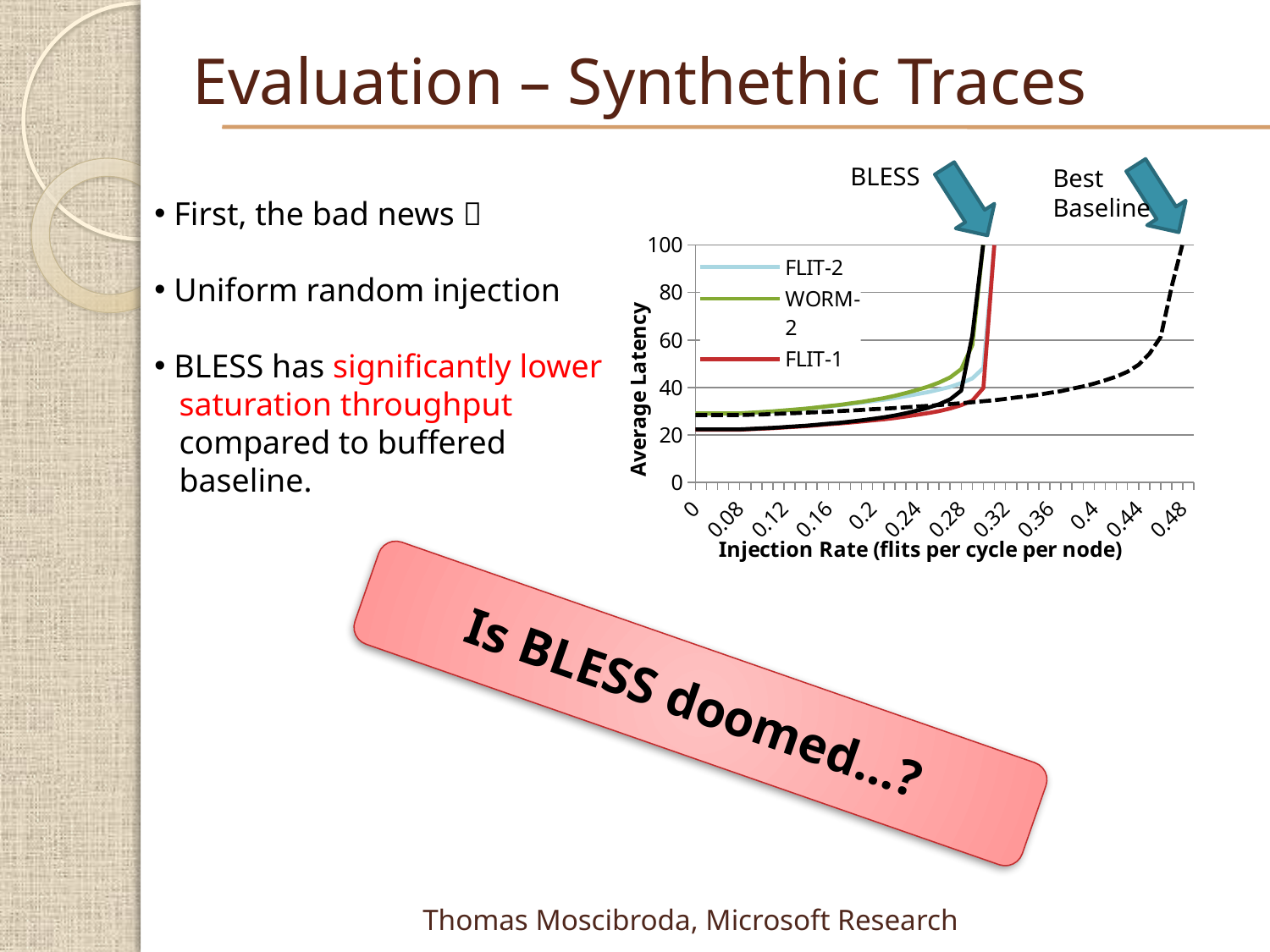
How many series does the chart's legend list? 3 What is the highest value shown on the chart's y axis? 100 Is the average latency for WORM-2 at an injection rate of 0.08 greater or less than 60? less At an injection rate of 0.24, which has the higher average latency, WORM-2 or FLIT-1? WORM-2 Does the average latency rise or fall as the injection rate increases along the x axis? rise Is the average latency of the dashed Best Baseline curve at an injection rate of 0.48 greater or less than 60? greater What is the label of the chart's x axis? Injection Rate (flits per cycle per node) What kind of chart is shown on the slide? line chart What is the label of the chart's y axis? Average Latency Is the average latency for FLIT-2 at an injection rate of 0.12 greater or less than 20? greater Which curve reaches the highest injection rate before its latency shoots up, the BLESS curve or the Best Baseline curve? Best Baseline